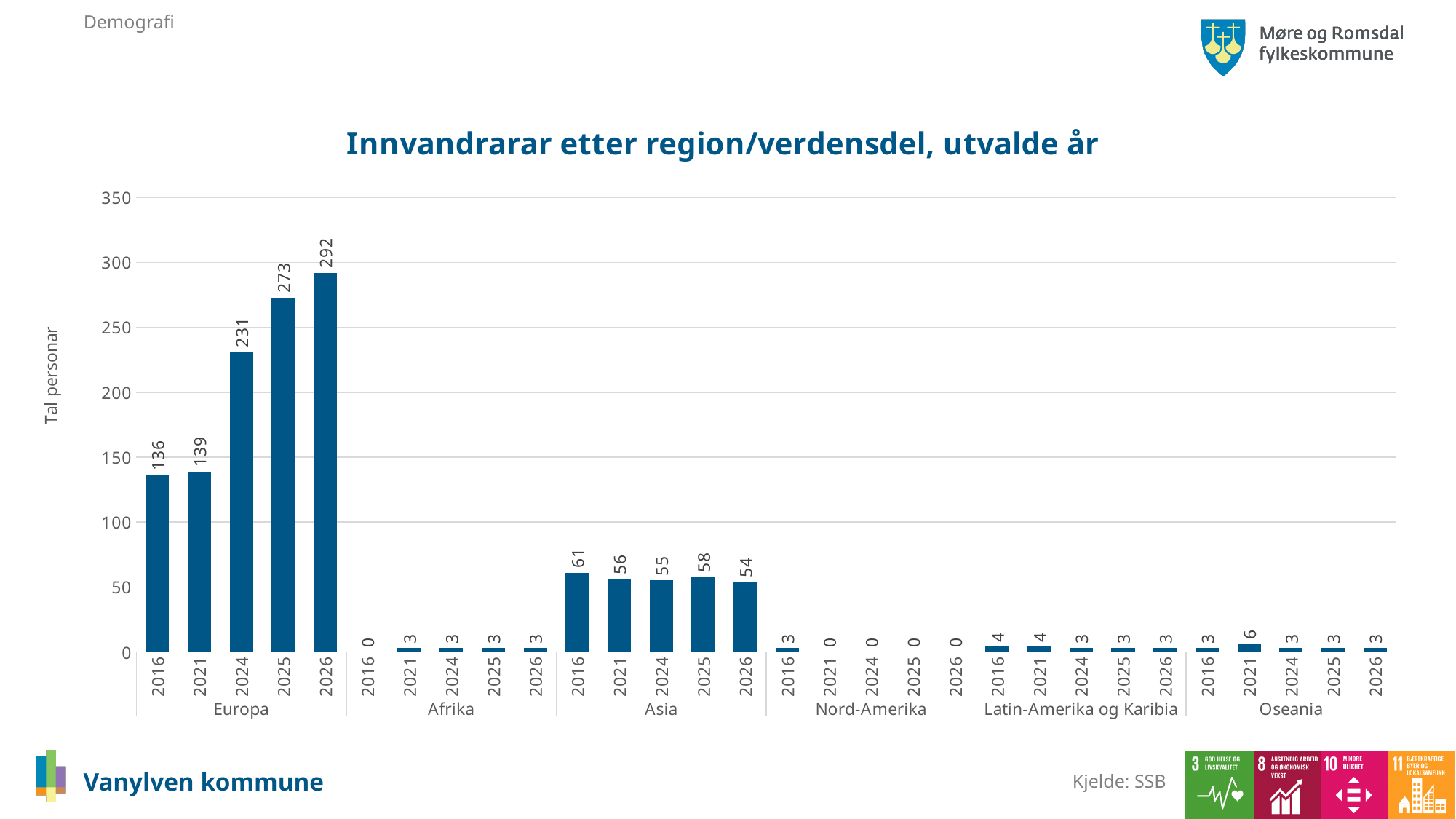
What is the difference between the Europa values for 2026 and 2016? 156 Which year has the lowest value for Europa? 2016 What is the title of the chart? Innvandrarar etter region/verdensdel, utvalde år How many regions are shown on the x axis? 6 What is the value for Oseania in 2021? 6 Do the values for Europa rise or fall from 2016 to 2026? Rise What kind of chart is this? Bar chart Which region has the highest bar in the chart? Europa What is the value for Europa in 2026? 292 What is the value for Nord-Amerika in 2016? 3 What is the value for Asia in 2016? 61 Which is larger: Asia in 2025 or Asia in 2021? Asia in 2025